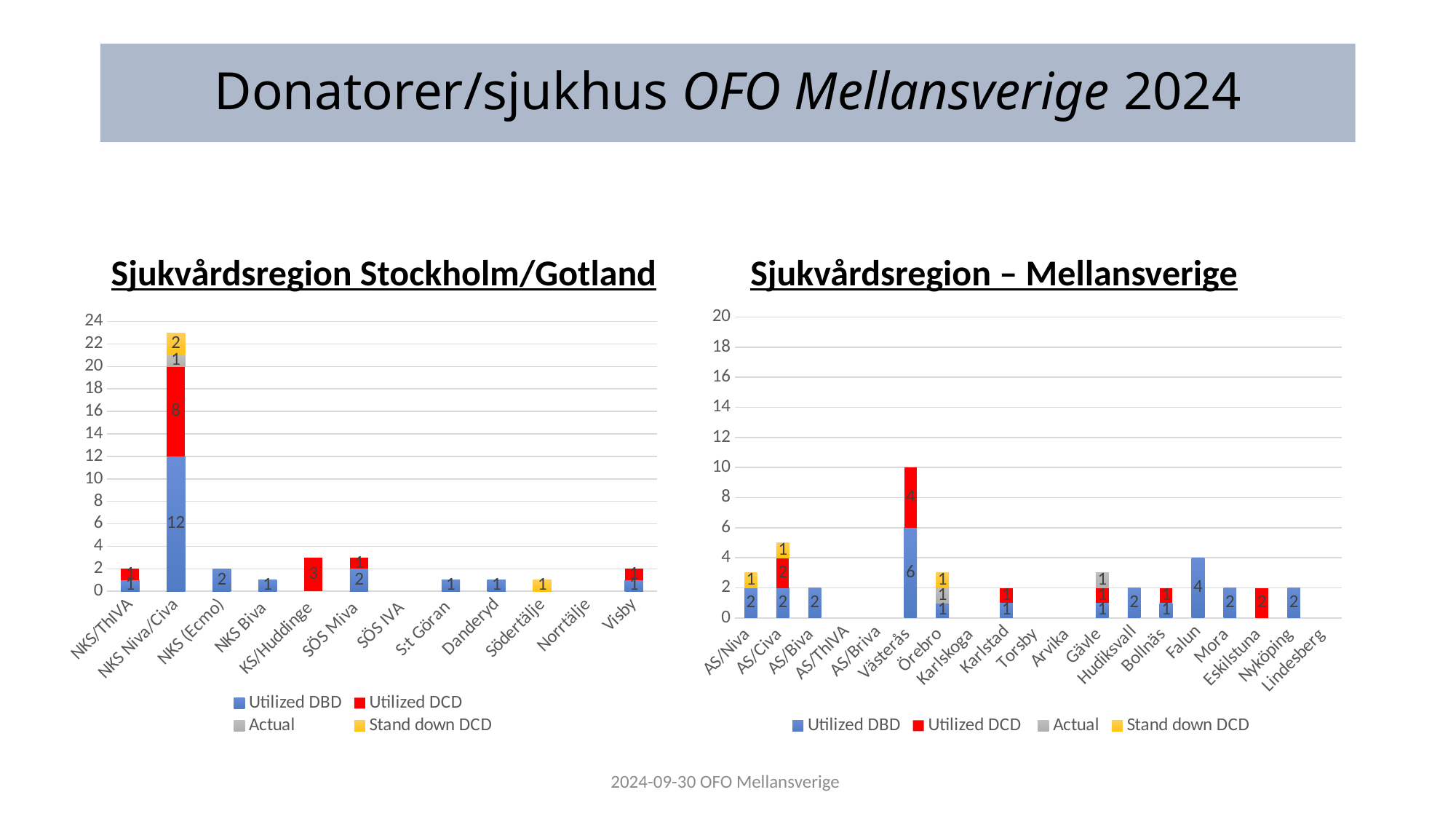
In the Sjukvårdsregion – Mellansverige chart, what is the Utilized DCD value for Eskilstuna? 2 In the Sjukvårdsregion Stockholm/Gotland chart, what is the total height of the stacked bar for NKS Niva/Civa? 23 In the Sjukvårdsregion – Mellansverige chart, what is the difference between the Utilized DBD values for Västerås and Falun? 2 In the Sjukvårdsregion Stockholm/Gotland chart, what is the Utilized DBD value for NKS Niva/Civa? 12 In the Sjukvårdsregion – Mellansverige chart, what is the Utilized DBD value for Västerås? 6 In the Sjukvårdsregion – Mellansverige chart, what is the total of the stacked bar for AS/Civa? 5 In the Sjukvårdsregion Stockholm/Gotland chart, what is the Utilized DCD value for KS/Huddinge? 3 In the Sjukvårdsregion – Mellansverige chart, which is larger, the Utilized DBD value for Falun or for Hudiksvall? Falun In the Sjukvårdsregion Stockholm/Gotland chart, how many hospital categories are shown on the x axis? 12 In the Sjukvårdsregion Stockholm/Gotland chart, how many series does the legend list? 4 In the Sjukvårdsregion Stockholm/Gotland chart, which hospital has the highest total bar? NKS Niva/Civa What type of chart is the Sjukvårdsregion – Mellansverige chart? Stacked bar chart